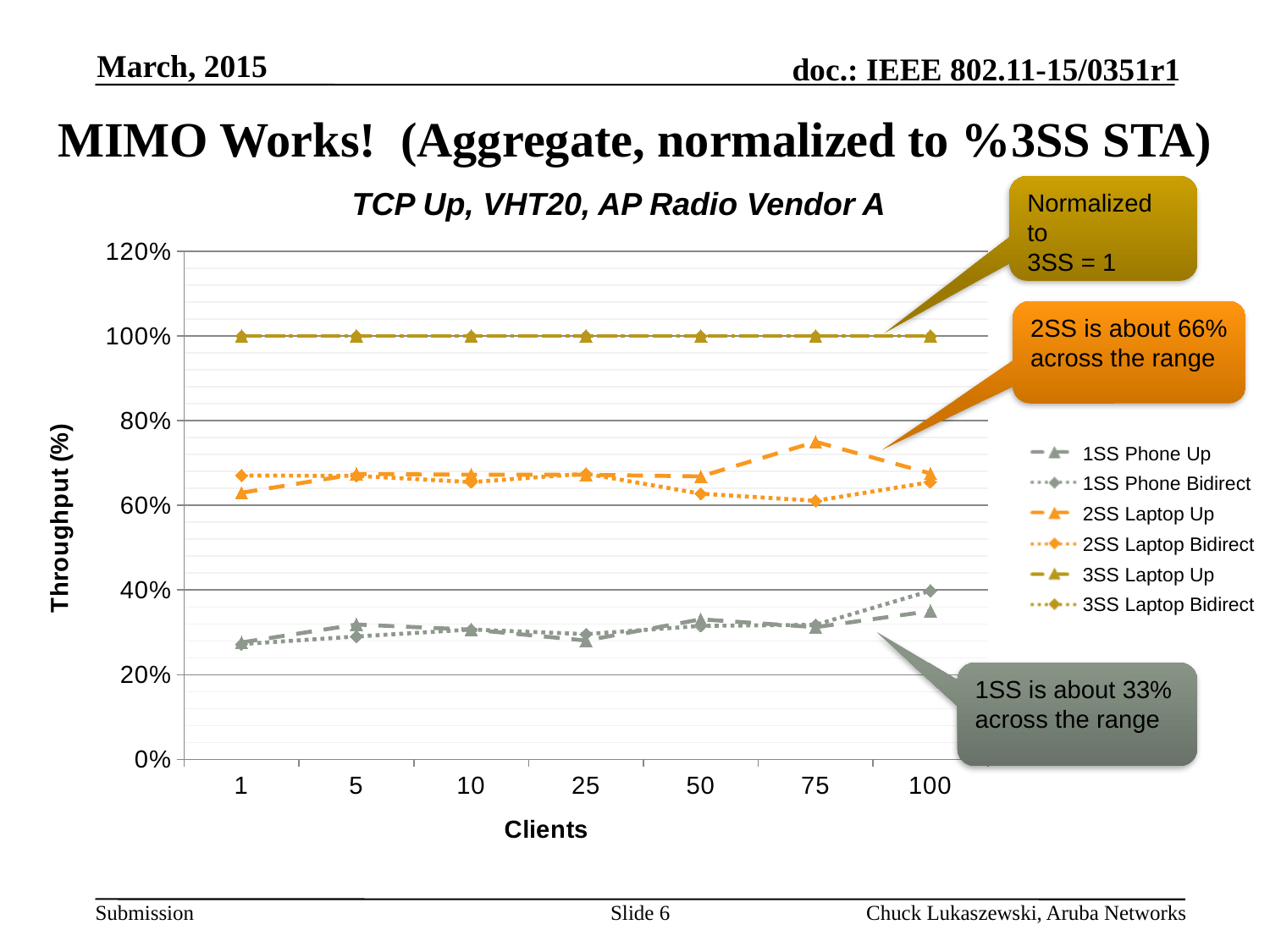
What kind of chart is shown on the slide? line chart Does the 3SS Laptop Up line rise, fall, or stay flat as the number of clients increases? stays flat Is the value for 2SS Laptop Up at 75 clients greater or less than 60%? greater At 25 clients, which is larger: 2SS Laptop Up or 1SS Phone Up? 2SS Laptop Up What is the throughput value for 3SS Laptop Bidirect at 100 clients? 100% What is the throughput value for 3SS Laptop Up at 1 client? 100% Is the value for 2SS Laptop Bidirect at 75 clients greater or less than 40%? greater Is the value for 1SS Phone Up at 100 clients greater or less than 40%? less What is the title of the chart? TCP Up, VHT20, AP Radio Vendor A How many series does the legend list? 6 How many client values are plotted along the x axis? 7 At 75 clients, which is larger: 2SS Laptop Up or 2SS Laptop Bidirect? 2SS Laptop Up